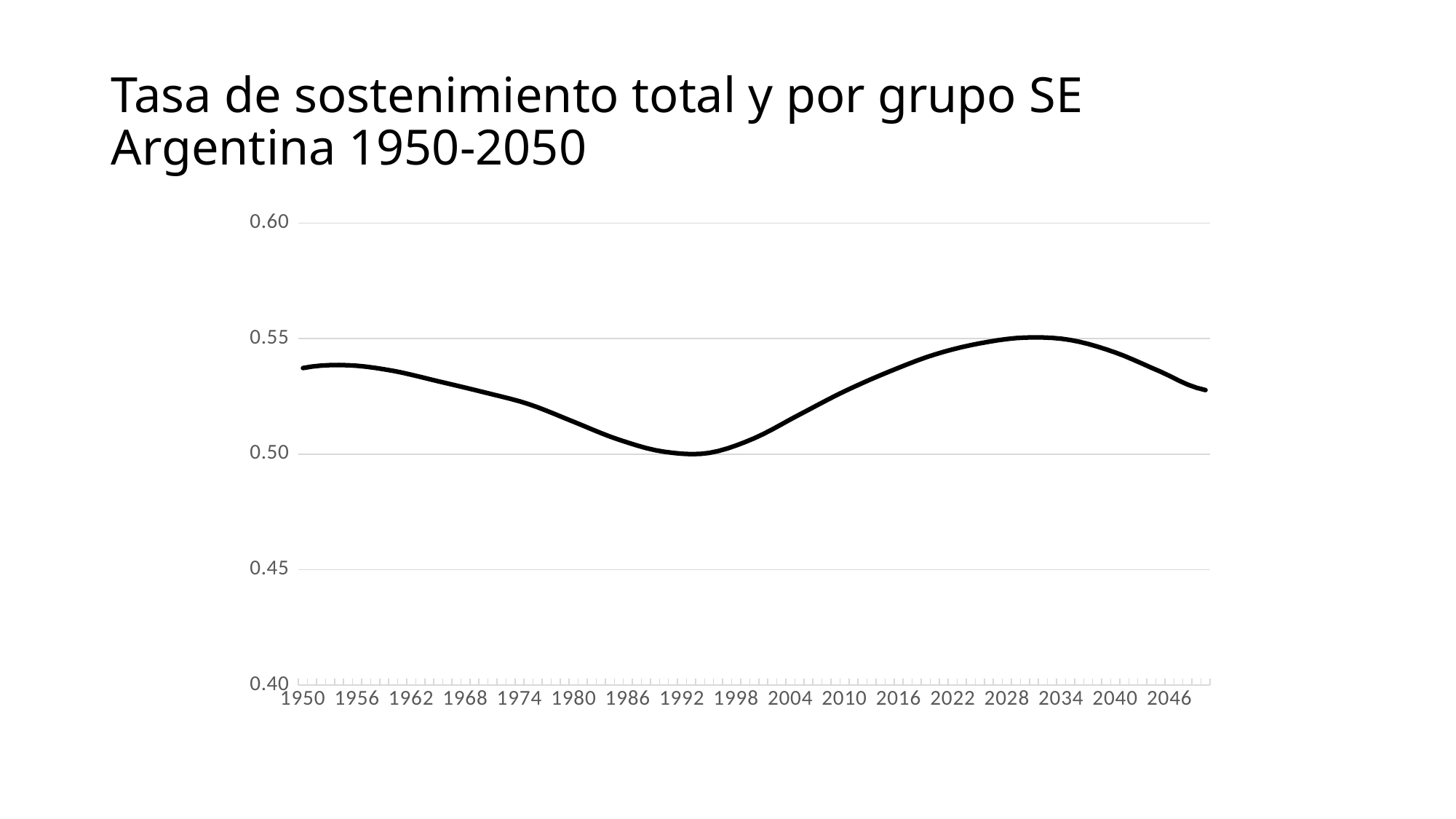
Is the value for 2046 greater or less than 0.50? greater Is the value for 2046 greater or less than 0.55? less What is the title of the chart on the slide? Tasa de sostenimiento total y por grupo SE Argentina 1950-2050 How many lines (series) are plotted on the chart? 1 Is the value for 1950 greater or less than 0.55? less Does the line rise or fall between 1950 and 1992? fall Does the line rise or fall between 1998 and 2028? rise Which is larger, the value for 1950 or the value for 1992? 1950 Which is larger, the value for 2028 or the value for 1992? 2028 What kind of chart is shown on the slide? line chart